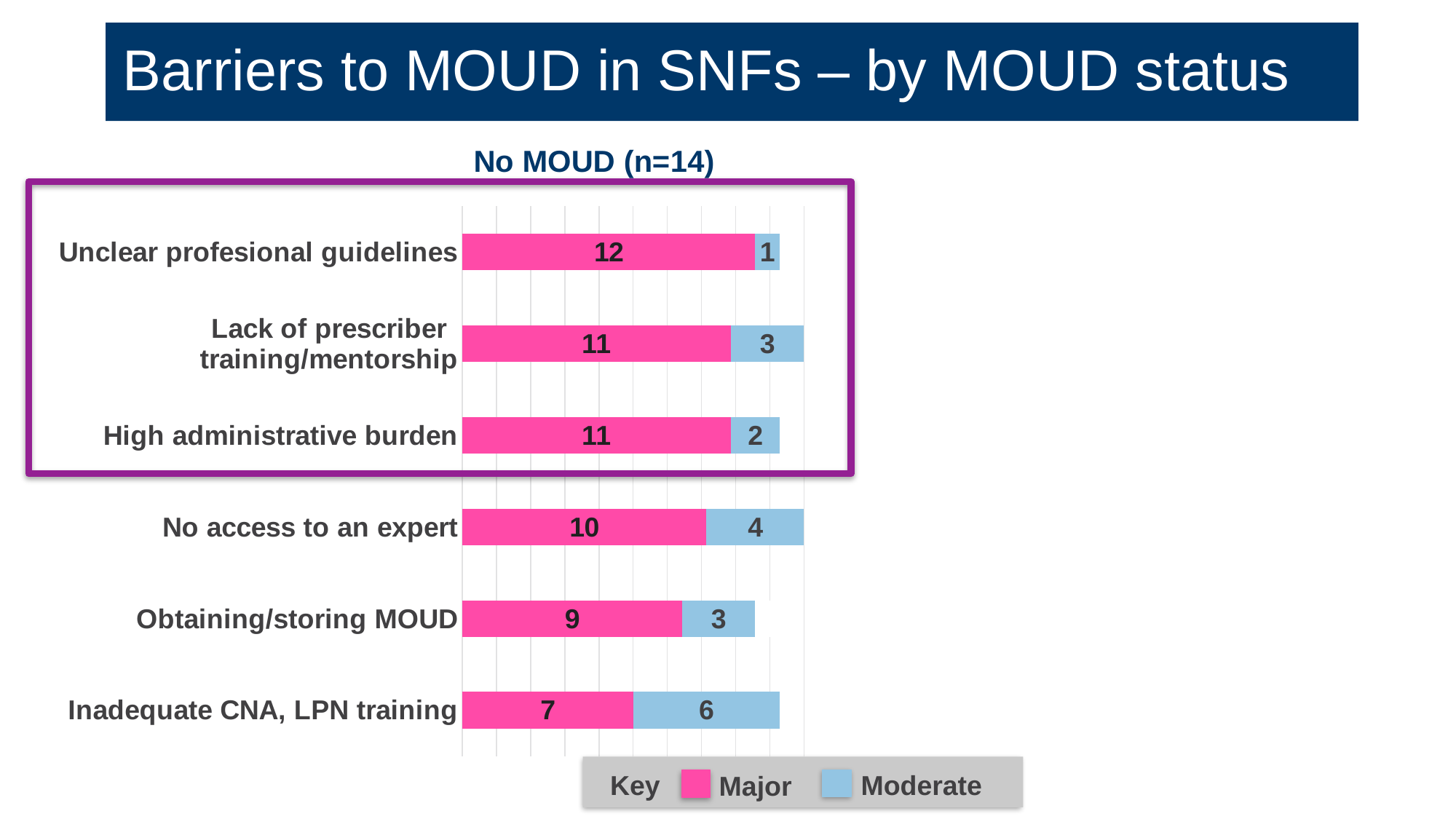
What is the Moderate value for No access to an expert? 4 Which category has the lowest Major value? Inadequate CNA, LPN training How many series does the key list? 2 What kind of chart is shown on the slide? Stacked bar chart What is the Moderate value for Inadequate CNA, LPN training? 6 How many categories are shown in the chart? 6 What is the difference between the Major and Moderate values for Obtaining/storing MOUD? 6 What is the Major value for Unclear profesional guidelines? 12 Which is larger: the Major value for No access to an expert or the Major value for Obtaining/storing MOUD? No access to an expert What is the total of the stacked bar for Lack of prescriber training/mentorship? 14 Which category has the lowest Moderate value? Unclear profesional guidelines Which category has the highest Major value? Unclear profesional guidelines